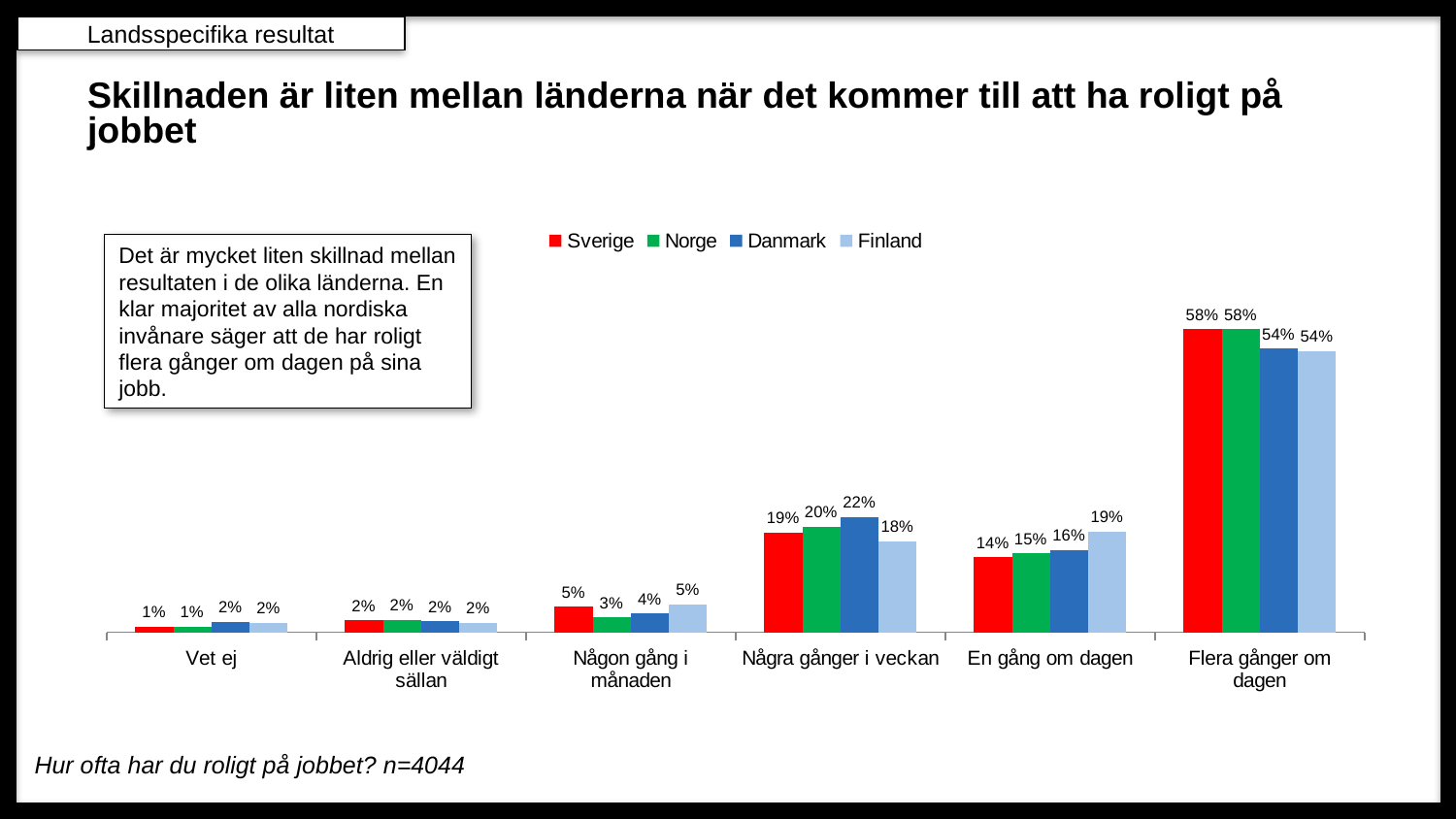
Which category has the highest values for all four countries? Flera gånger om dagen What kind of chart is shown on the slide? Bar chart What is the value for Finland in the 'En gång om dagen' category? 19% In the 'En gång om dagen' category, which is larger: Finland or Sverige? Finland How many categories are shown on the x axis? 6 What is the value for Norge in the 'Någon gång i månaden' category? 3% How many series does the legend list? 4 Which series is shown in red in the legend? Sverige What is the value for Danmark in the 'Några gånger i veckan' category? 22% Which country has the lowest value in the 'Några gånger i veckan' category? Finland What is the value for Sverige in the 'Flera gånger om dagen' category? 58% What is the difference between Sverige and Danmark in the 'Flera gånger om dagen' category? 4%